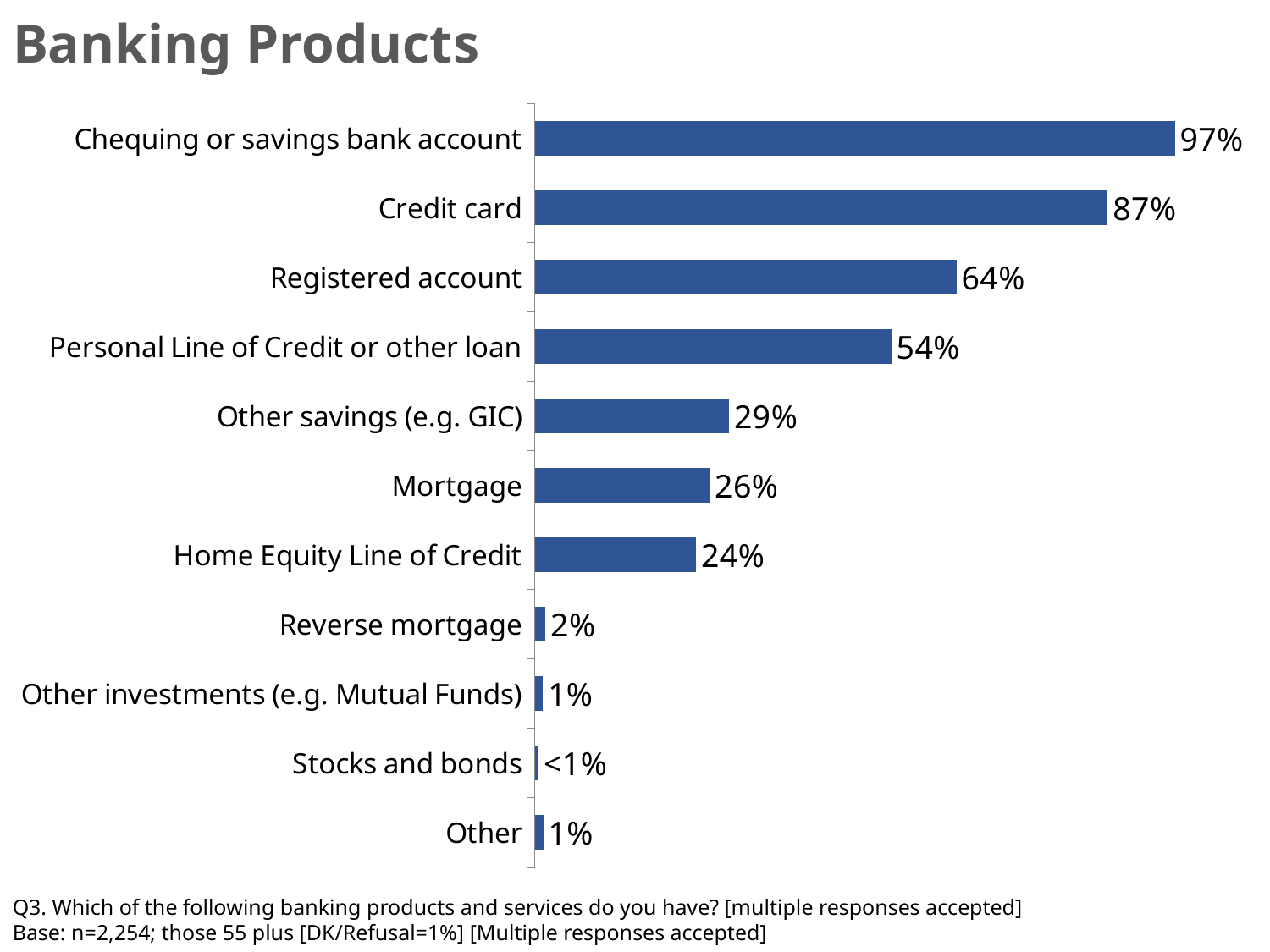
What is the title of the chart? Banking Products Which is larger, the value for Other savings (e.g. GIC) or the value for Mortgage? Other savings (e.g. GIC) What value is shown for Stocks and bonds? <1% What percentage of respondents have a Home Equity Line of Credit? 24% Which banking product has the lowest percentage? Stocks and bonds What type of chart is shown on the slide? Bar chart Which banking product has the highest percentage? Chequing or savings bank account What is the value shown for Credit card? 87% What is the difference between the percentages for Credit card and Mortgage? 61% What is the difference between the percentages for Registered account and Personal Line of Credit or other loan? 10% How many banking product categories are shown in the chart? 11 What percentage of respondents have a chequing or savings bank account? 97%